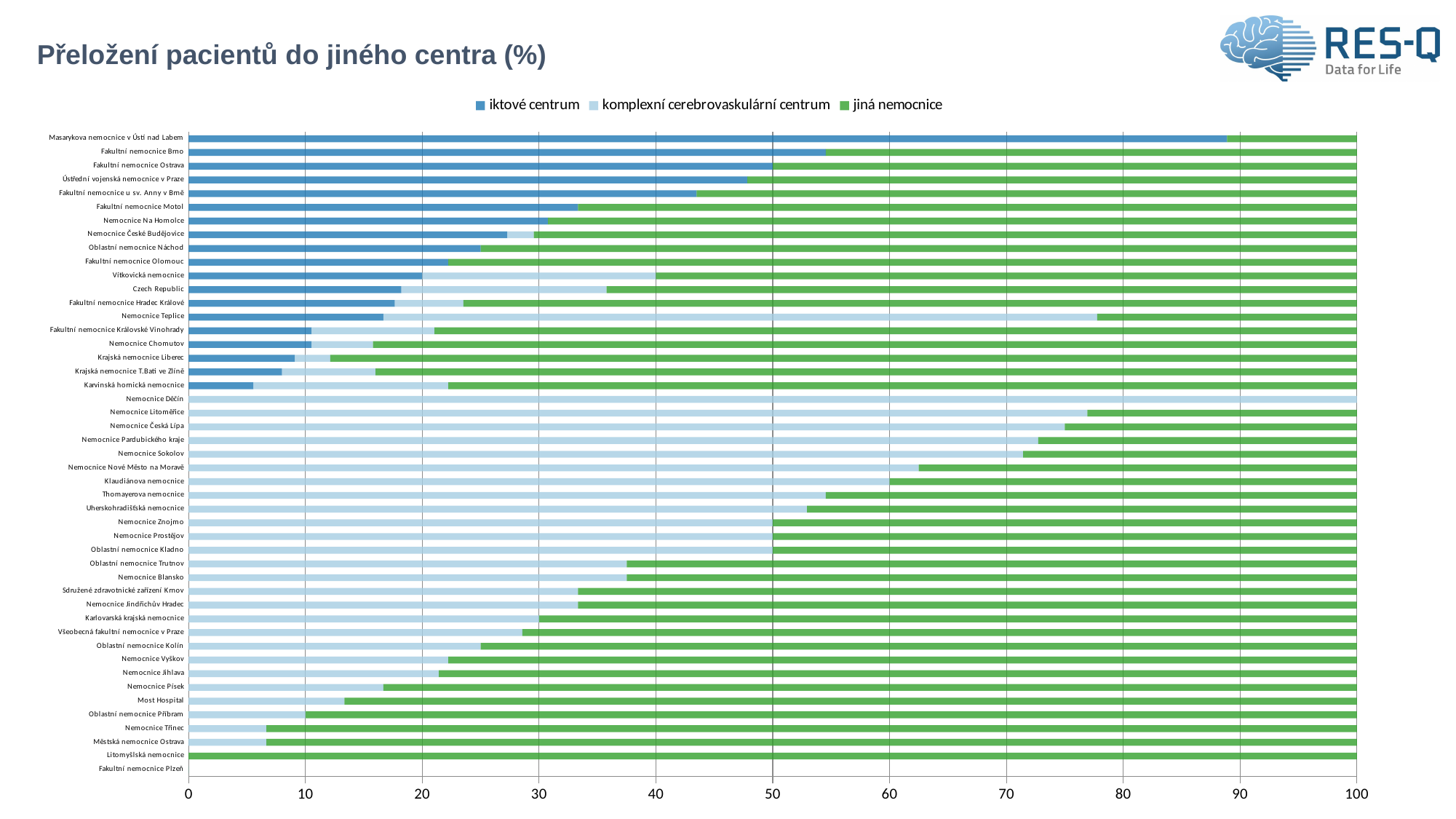
Which hospital has the highest value for 'iktové centrum'? Masarykova nemocnice v Ústí nad Labem What is the 'jiná nemocnice' value for Litomyšlská nemocnice? 100 What kind of chart is shown on the slide? bar chart Is the 'komplexní cerebrovaskulární centrum' value for Nemocnice Sokolov greater or less than 60? greater Which colour represents the series 'jiná nemocnice' in the chart? green How many series does the legend list? 3 What is the title of the chart? Přeložení pacientů do jiného centra (%) Is the 'komplexní cerebrovaskulární centrum' value for Most Hospital greater or less than 20? less Is the 'iktové centrum' value for Masarykova nemocnice v Ústí nad Labem greater or less than 80? greater Which is larger: the 'iktové centrum' value for Fakultní nemocnice Ostrava or for Fakultní nemocnice Motol? Fakultní nemocnice Ostrava